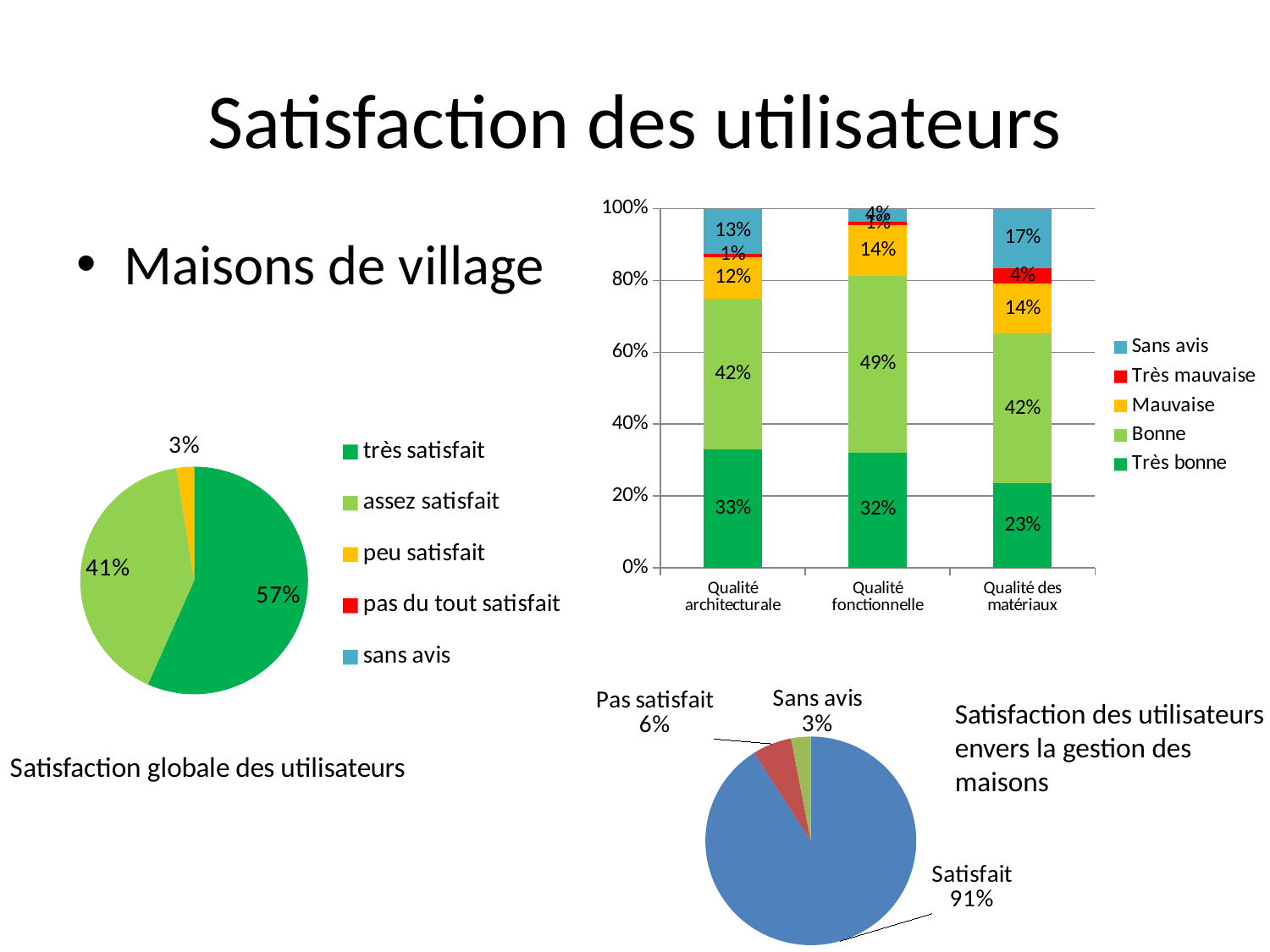
In the pie chart titled 'Satisfaction globale des utilisateurs', which slice is larger: 'très satisfait' or 'assez satisfait'? très satisfait In the stacked bar chart, what is the 'Très bonne' value for Qualité des matériaux? 23% In the stacked bar chart, what is the difference between the 'Bonne' values for Qualité fonctionnelle and Qualité architecturale? 7% In the stacked bar chart, what is the 'Bonne' value for Qualité fonctionnelle? 49% In the pie chart titled 'Satisfaction globale des utilisateurs', what share is 'très satisfait'? 57% In the stacked bar chart, how many categories are shown on the x axis? 3 What kind of chart is the chart in the top right of the slide? Stacked bar chart In the stacked bar chart, what is the 'Sans avis' value for Qualité architecturale? 13% In the stacked bar chart, which category has the highest 'Sans avis' value? Qualité des matériaux In the pie chart titled 'Satisfaction des utilisateurs envers la gestion des maisons', what share is 'Satisfait'? 91% In the stacked bar chart, how many series does the legend list? 5 In the stacked bar chart, which category has the lowest 'Très bonne' value? Qualité des matériaux